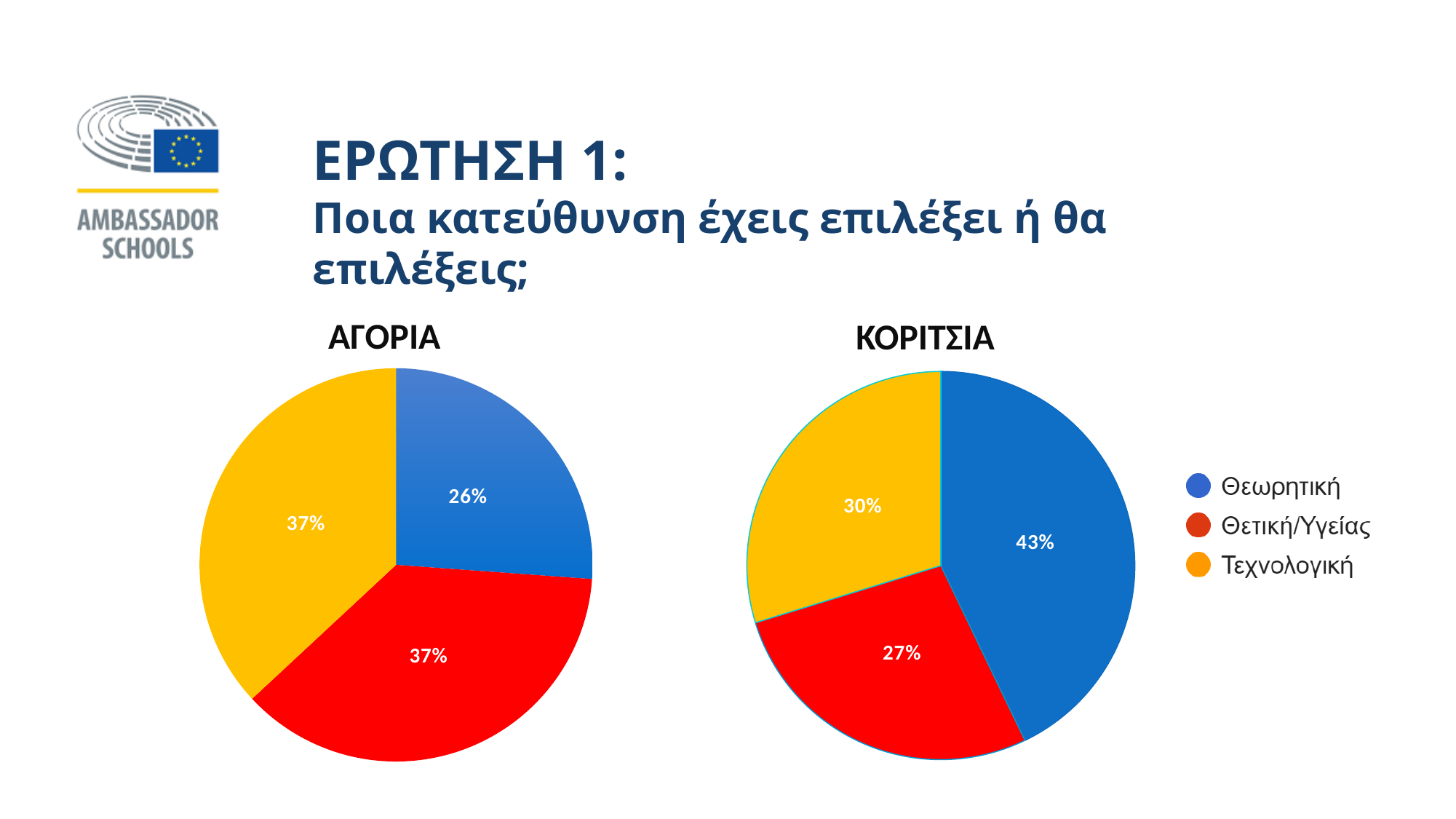
In the ΚΟΡΙΤΣΙΑ chart, what is the value for Τεχνολογική? 30% In the ΚΟΡΙΤΣΙΑ chart, what share of the pie is Θεωρητική? 43% Which colour represents Τεχνολογική in the legend? Yellow What type of chart is used for ΑΓΟΡΙΑ and ΚΟΡΙΤΣΙΑ? Pie chart How many slices does the ΑΓΟΡΙΑ pie chart have? 3 In the ΚΟΡΙΤΣΙΑ chart, which category has the smallest slice? Θετική/Υγείας In the ΑΓΟΡΙΑ chart, what is the value for Θετική/Υγείας? 37% In the ΑΓΟΡΙΑ chart, which category has the smallest slice? Θεωρητική In the ΚΟΡΙΤΣΙΑ chart, what is the difference in percentage points between Θεωρητική and Θετική/Υγείας? 16 percentage points In the ΚΟΡΙΤΣΙΑ chart, which category has the largest slice? Θεωρητική In the ΑΓΟΡΙΑ chart, what share of the pie is Θεωρητική? 26% Is the Θεωρητική share larger in the ΑΓΟΡΙΑ chart or the ΚΟΡΙΤΣΙΑ chart? ΚΟΡΙΤΣΙΑ